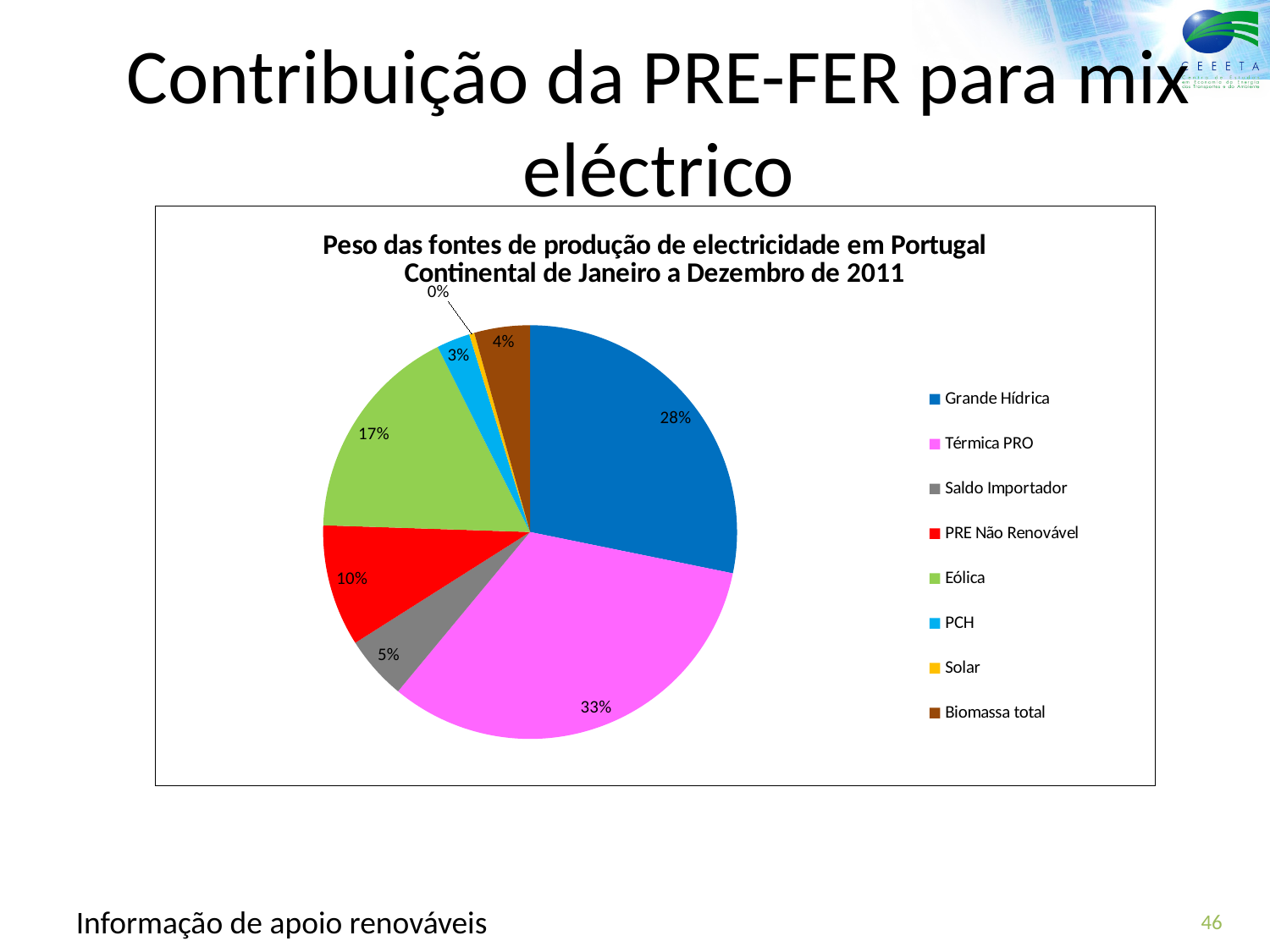
What share of the pie does Biomassa total have? 4% Which source has the largest share of the pie? Térmica PRO What is the title of the chart? Peso das fontes de produção de electricidade em Portugal Continental de Janeiro a Dezembro de 2011 Which source has the smallest share of the pie? Solar How many sources does the legend list? 8 What share of the pie does Eólica have? 17% What is the difference between the shares of Térmica PRO and Grande Hídrica? 5% Which has a larger share, Eólica or PRE Não Renovável? Eólica What share of the pie does Grande Hídrica have? 28% What kind of chart is shown on the slide? pie chart